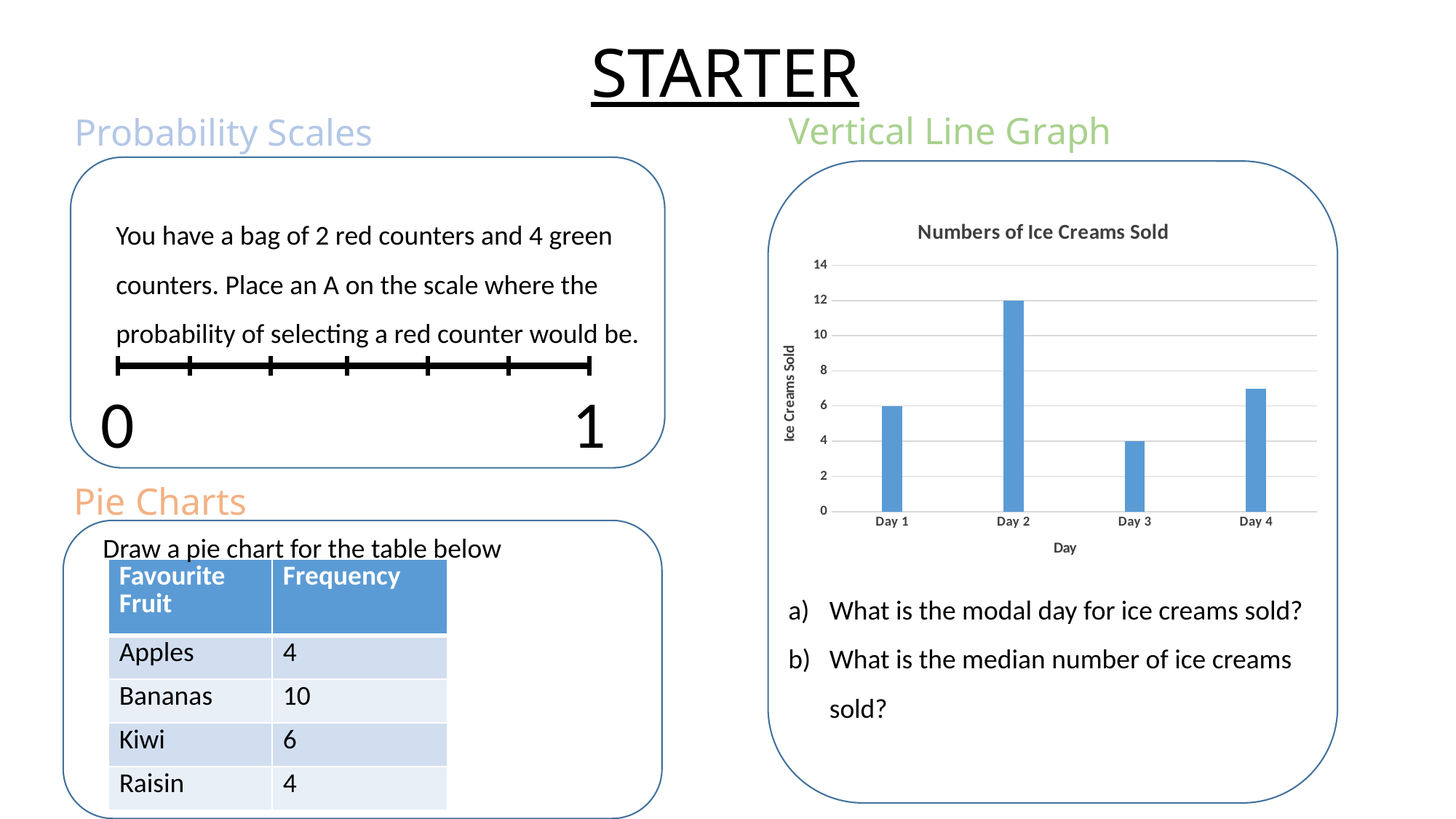
What is the title of the chart? Numbers of Ice Creams Sold What is the difference between the number of ice creams sold on Day 2 and Day 1? 6 Which day has the highest number of ice creams sold? Day 2 How many ice creams were sold on Day 1? 6 Is the value for Day 4 greater or less than 6? greater Which day has the lowest number of ice creams sold? Day 3 What is the label on the y axis of the chart? Ice Creams Sold How many ice creams were sold on Day 3? 4 What type of chart is used to show the numbers of ice creams sold? bar chart How many ice creams were sold on Day 2? 12 Which day had more ice creams sold, Day 1 or Day 3? Day 1 How many days are shown on the x axis of the chart? 4